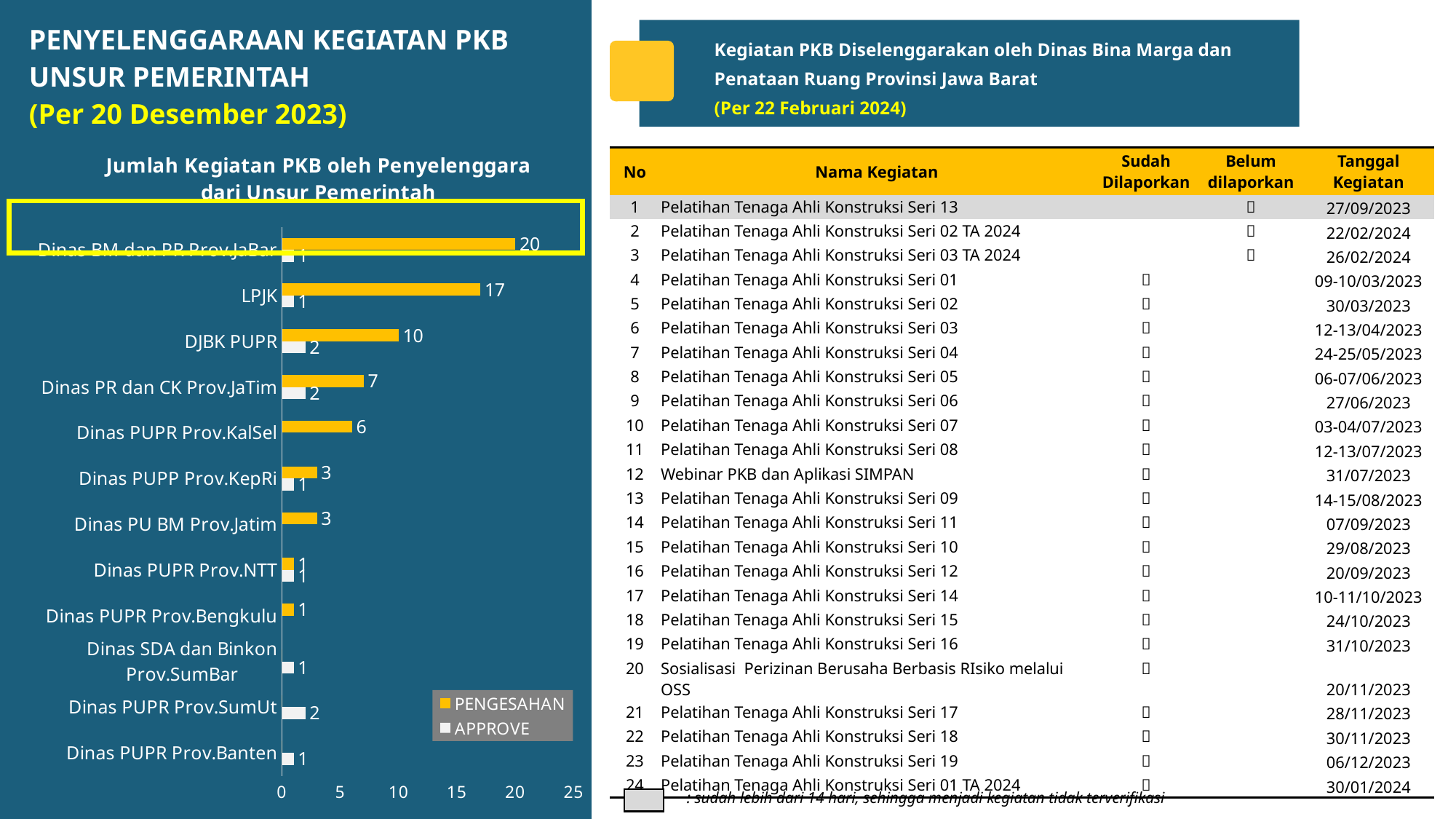
What is the PENGESAHAN value for Dinas PUPR Prov.KalSel? 6 Which colour represents the PENGESAHAN series in the chart? yellow What is the difference between the PENGESAHAN values of Dinas BM dan PR Prov.JaBar and LPJK? 3 What type of chart is shown on the slide? bar chart What is the PENGESAHAN value for LPJK? 17 Which category has the highest PENGESAHAN value? Dinas BM dan PR Prov.JaBar How many categories (penyelenggara) are shown on the chart's axis? 12 How many series does the chart legend list? 2 What is the PENGESAHAN value for Dinas BM dan PR Prov.JaBar? 20 What is the APPROVE value for DJBK PUPR? 2 What is the APPROVE value for Dinas PUPR Prov.SumUt? 2 Which is larger: the PENGESAHAN value for DJBK PUPR or for Dinas PR dan CK Prov.JaTim? DJBK PUPR